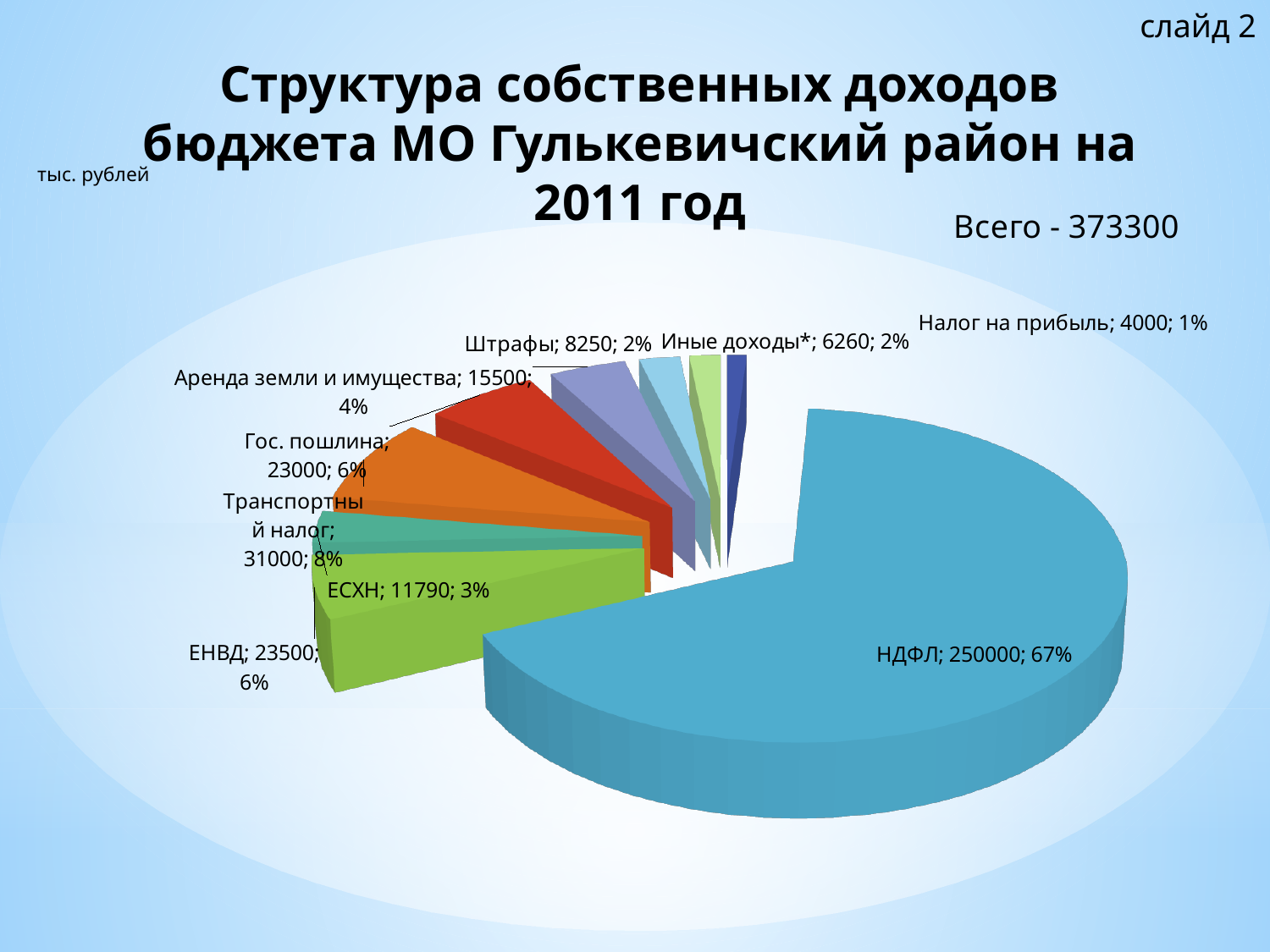
What is the value for ЕСХН? 11790 Which category has the smallest slice? Налог на прибыль Which is larger, the value for Штрафы or the value for Иные доходы*? Штрафы Which category has the largest slice? НДФЛ What kind of chart is shown on the slide? Pie chart What total is stated on the slide (Всего)? 373300 What share of the pie does НДФЛ represent? 67% What is the difference between the values for ЕНВД and Гос. пошлина? 500 What is the value for Транспортный налог? 31000 How many slices does the pie chart have? 9 What share of the pie does Гос. пошлина represent? 6% What is the value for НДФЛ? 250000